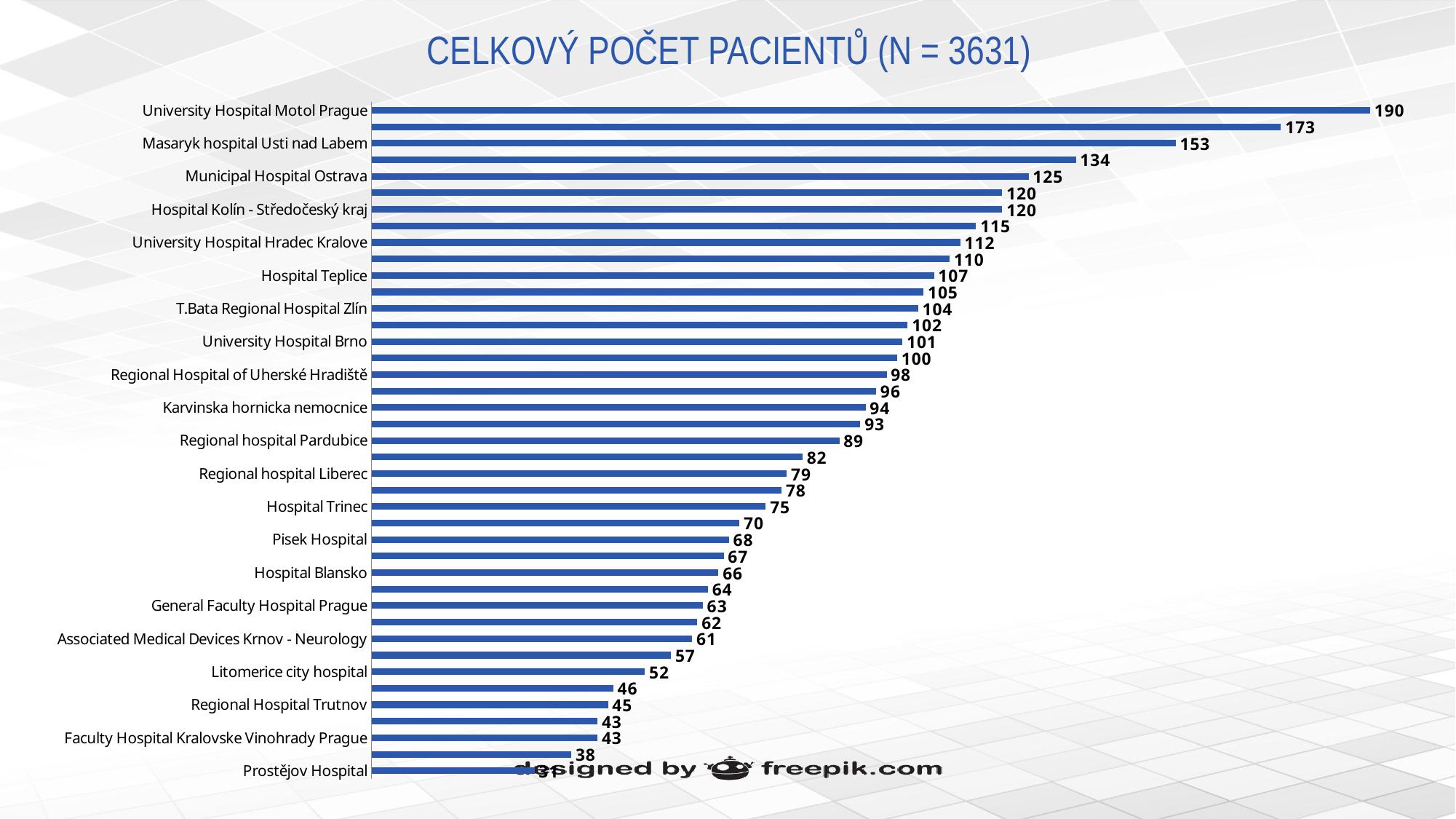
What is the difference between the values for University Hospital Motol Prague and Masaryk hospital Usti nad Labem? 37 What is the title of the chart? CELKOVÝ POČET PACIENTŮ (N = 3631) What is the value for Hospital Kolín - Středočeský kraj? 120 Are the bars ordered from largest to smallest going down the chart? Yes What is the value for University Hospital Motol Prague? 190 What is the value for Regional hospital Pardubice? 89 Which hospital has the lowest number of patients? Prostějov Hospital What type of chart is shown on the slide? Bar chart Which has a larger value, Hospital Teplice or Hospital Trinec? Hospital Teplice Which hospital has the highest number of patients? University Hospital Motol Prague What is the value for Masaryk hospital Usti nad Labem? 153 What is the value for Faculty Hospital Kralovske Vinohrady Prague? 43